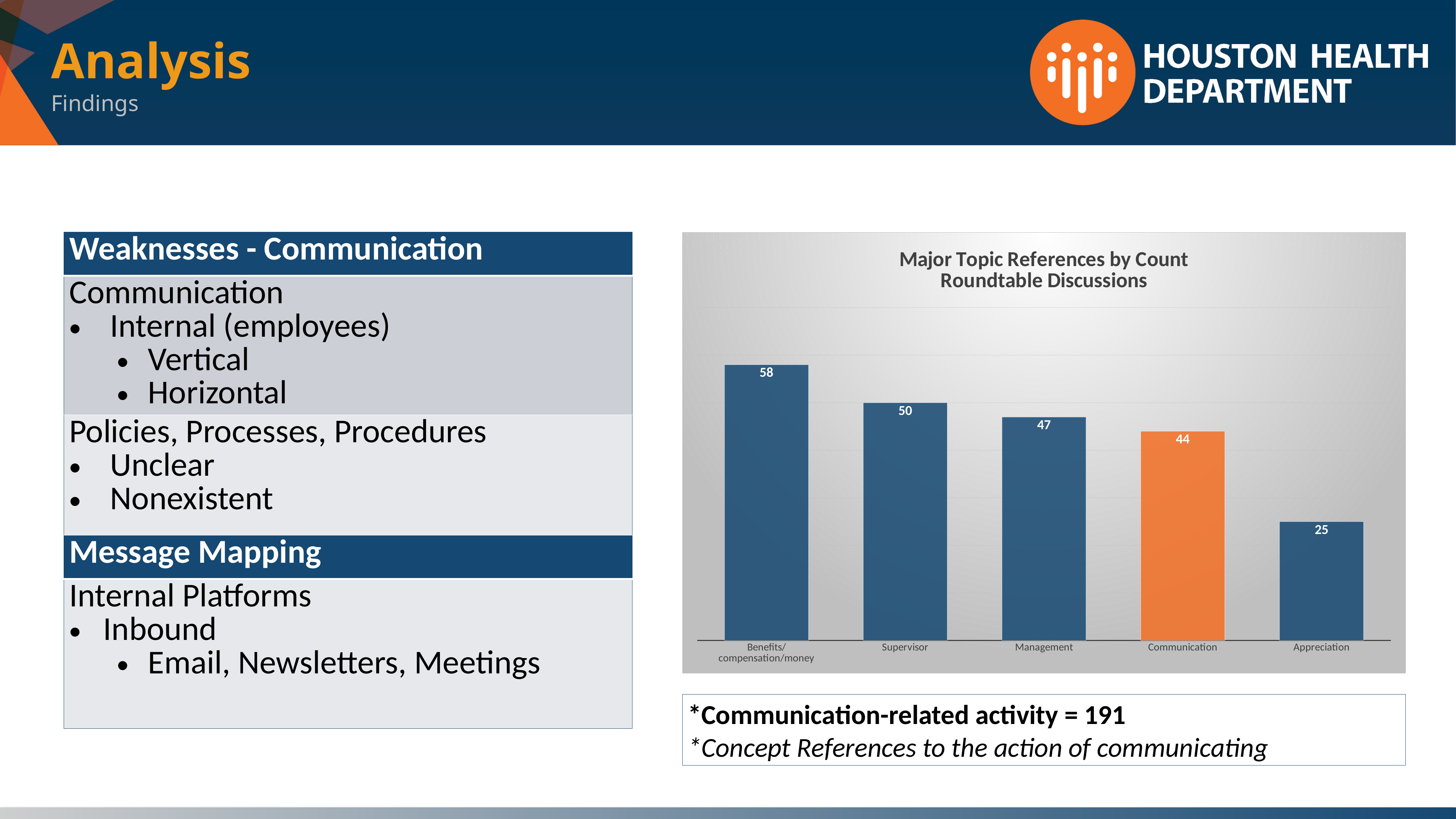
How many categories are shown in the chart? 5 Which bar in the chart is coloured orange? Communication Which category has the highest count? Benefits/compensation/money Which category has the lowest count? Appreciation What is the value for Benefits/compensation/money? 58 What is the difference between the values for Benefits/compensation/money and Appreciation? 33 What is the value for Management? 47 What is the value for Supervisor? 50 What is the value for Communication? 44 What kind of chart is shown on the slide? Bar chart What is the value for Appreciation? 25 Which is larger, the value for Supervisor or the value for Communication? Supervisor